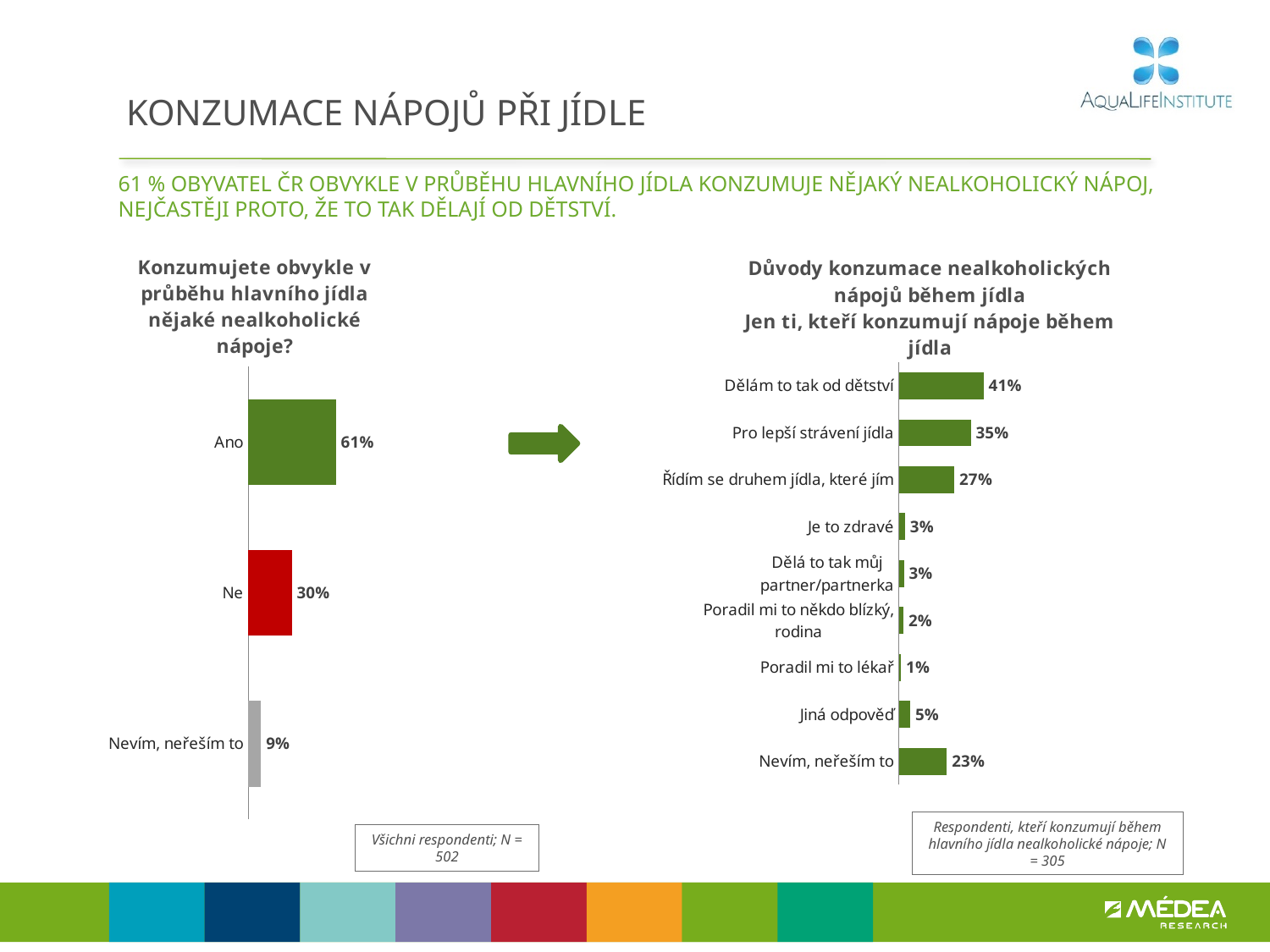
In the right chart, which category has the highest value? Dělám to tak od dětství In the left chart (Konzumujete obvykle v průběhu hlavního jídla nějaké nealkoholické nápoje?), what is the value for Ano? 61% In the right chart, how many categories are shown? 9 In the left chart, how many categories are shown? 3 In the right chart, what is the value for Poradil mi to lékař? 1% In the left chart, what is the value for Nevím, neřeším to? 9% In the right chart (Důvody konzumace nealkoholických nápojů během jídla), what is the value for Pro lepší strávení jídla? 35% What type of chart is the right chart? Bar chart In the right chart, what is the difference between Dělám to tak od dětství and Pro lepší strávení jídla? 6% In the left chart, what is the difference between Ano and Ne? 31% In the right chart, which is larger: Řídím se druhem jídla, které jím or Nevím, neřeším to? Řídím se druhem jídla, které jím In the left chart, which category has the lowest value? Nevím, neřeším to